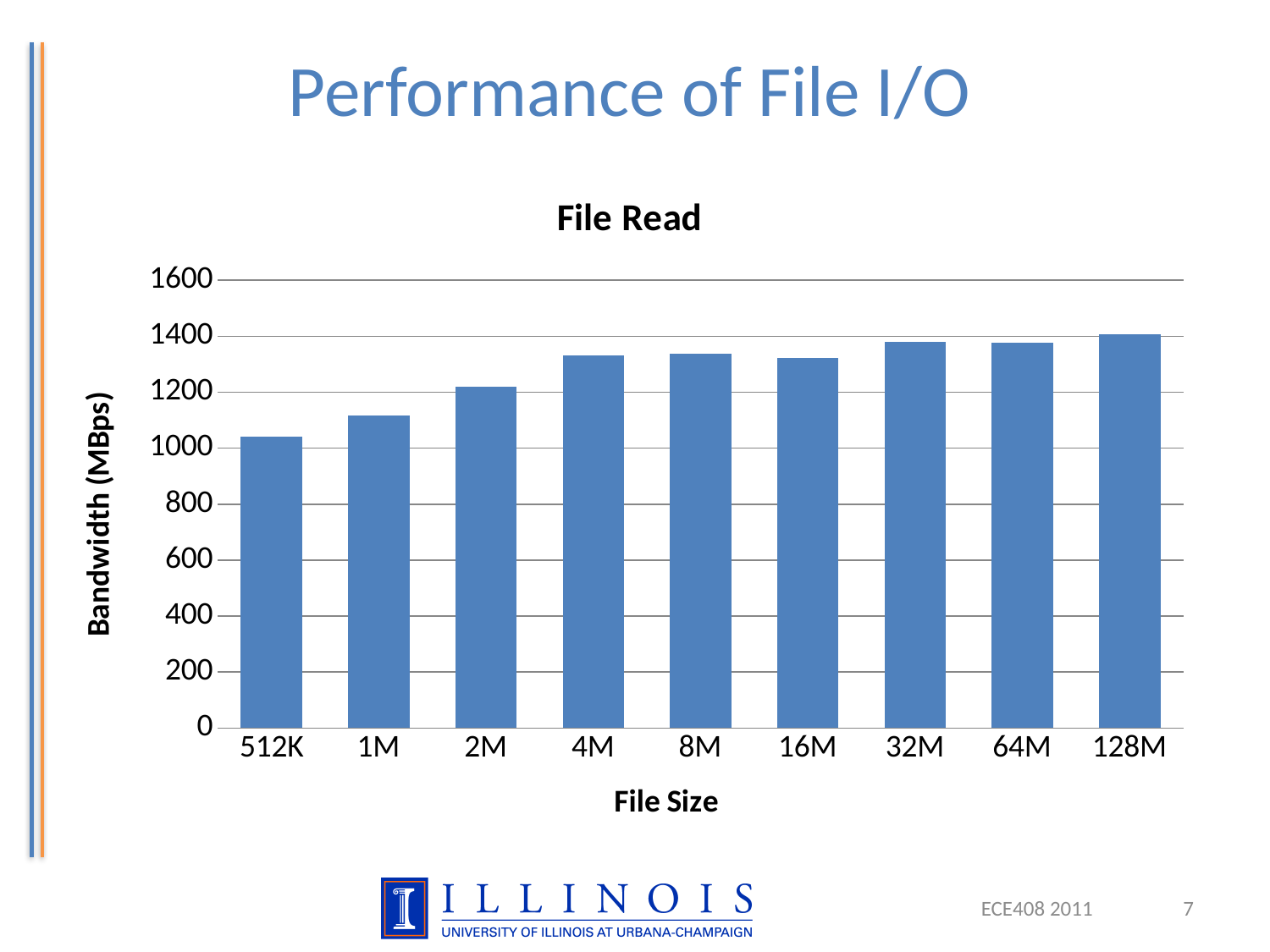
Is the bandwidth for 16M greater or less than 1400? less Which has the higher bandwidth, 512K or 2M? 2M Is the bandwidth for 512K greater or less than 1000? greater Which file size has the highest bandwidth? 128M Is the bandwidth for 2M greater or less than 1400? less Which file size has the lowest bandwidth? 512K What kind of chart is shown on the slide? bar chart Does the bandwidth generally rise or fall as file size increases along the x axis? rise What is the label of the vertical axis? Bandwidth (MBps) How many file sizes are plotted on the x axis? 9 What is the title of the chart? File Read